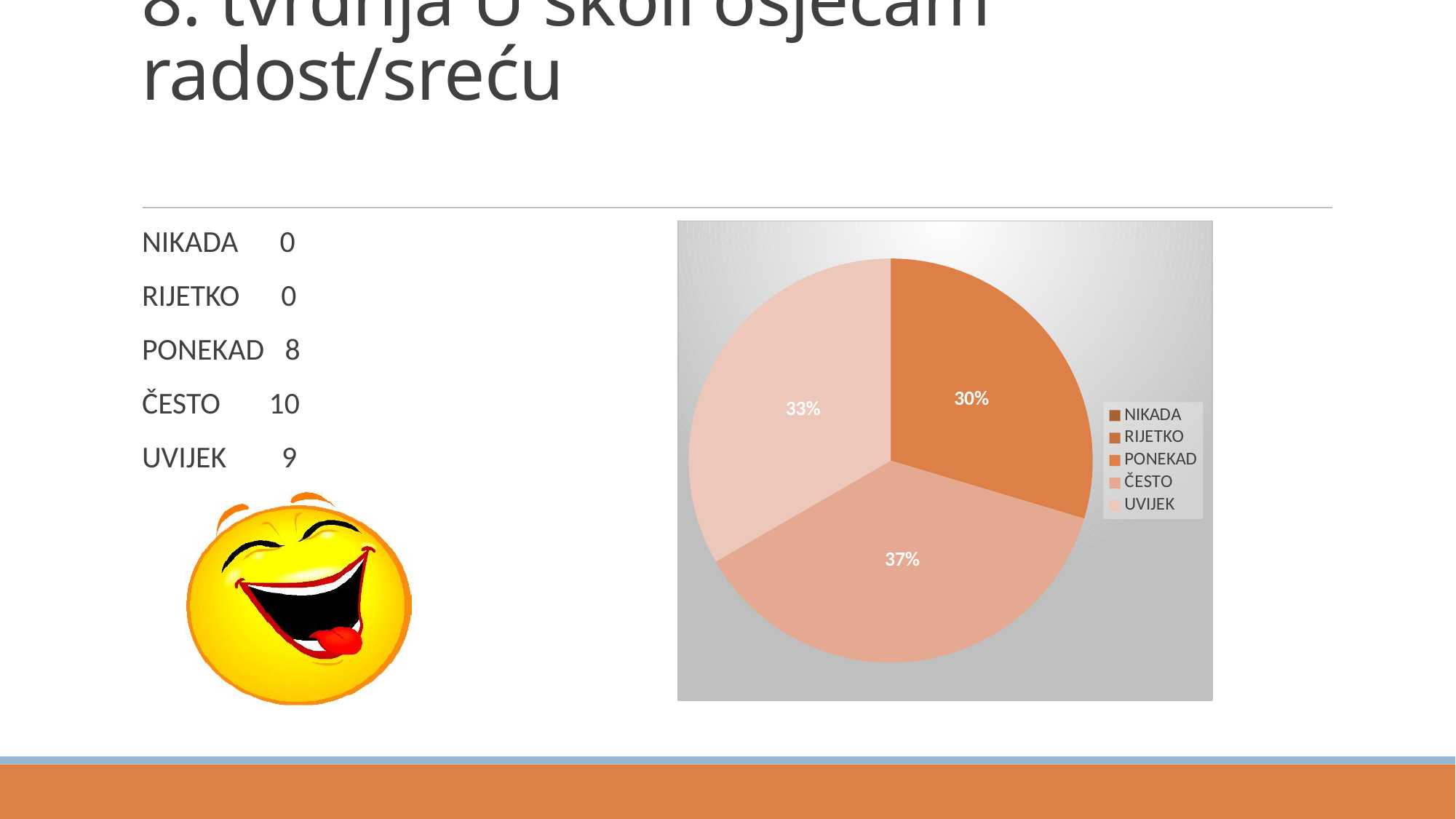
What percentage of the pie does the UVIJEK slice represent? 33% How many entries does the legend list? 5 Which slice is larger, ČESTO or UVIJEK? ČESTO Which slice is larger, UVIJEK or PONEKAD? UVIJEK Which legend entry is listed first? NIKADA What kind of chart is shown on the slide? pie chart How many slices with percentage labels are visible in the pie? 3 What is the difference in percentage points between the ČESTO slice and the PONEKAD slice? 7 What percentage of the pie does the PONEKAD slice represent? 30% Which category has the largest slice of the pie? ČESTO Which of the labelled slices is the smallest? PONEKAD What percentage of the pie does the ČESTO slice represent? 37%